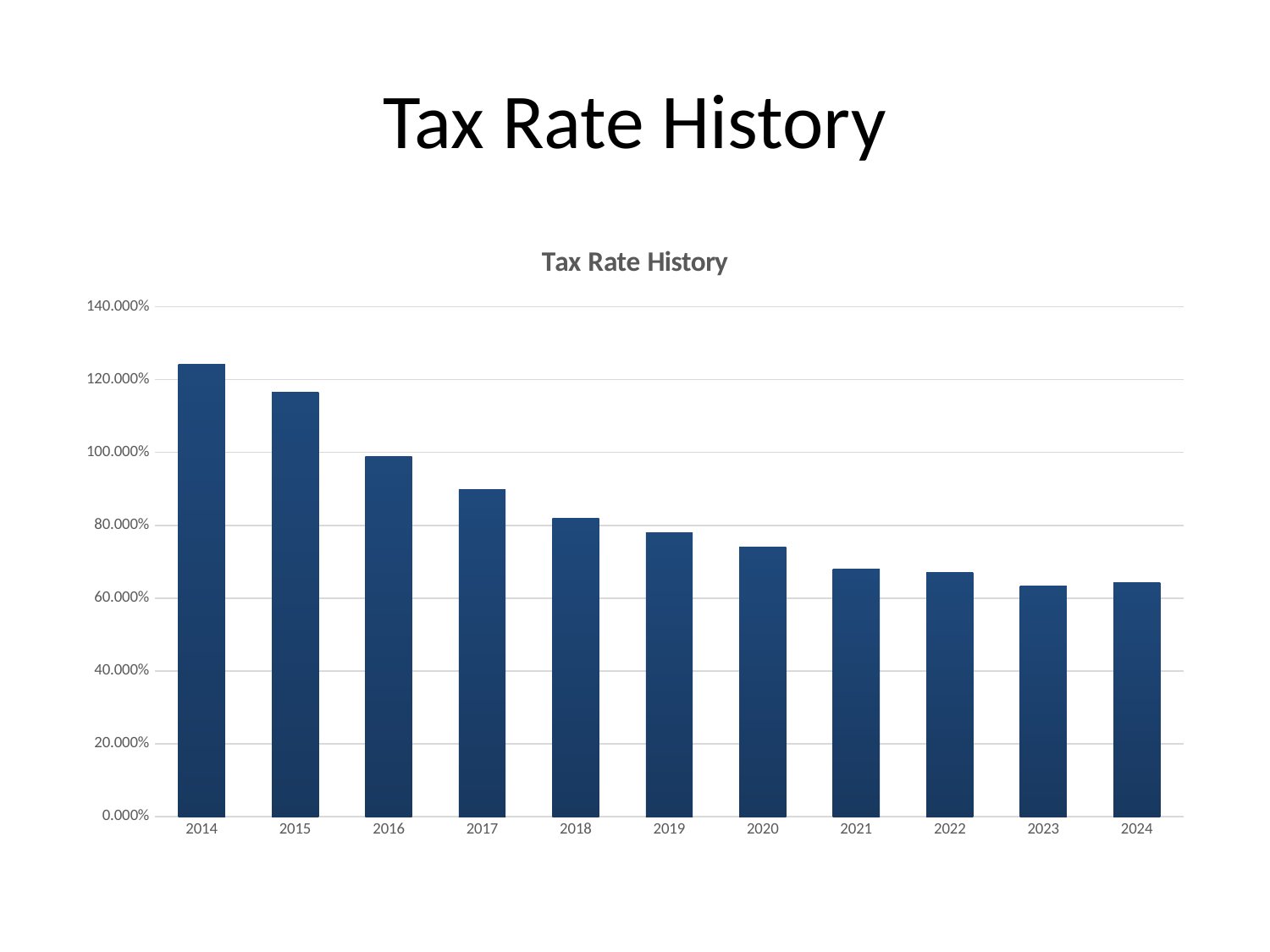
Which is larger, the value for 2014 or the value for 2024? 2014 Do the tax rate values generally rise or fall from 2014 to 2024? fall Is the value for 2020 greater or less than 80.000%? less Is the value for 2017 greater or less than 100.000%? less Which is larger, the value for 2016 or the value for 2020? 2016 What kind of chart is shown on the slide? bar chart How many years are shown on the x axis of the chart? 11 Is the value for 2014 greater or less than 120.000%? greater What is the title of the chart? Tax Rate History Which year has the highest tax rate in the chart? 2014